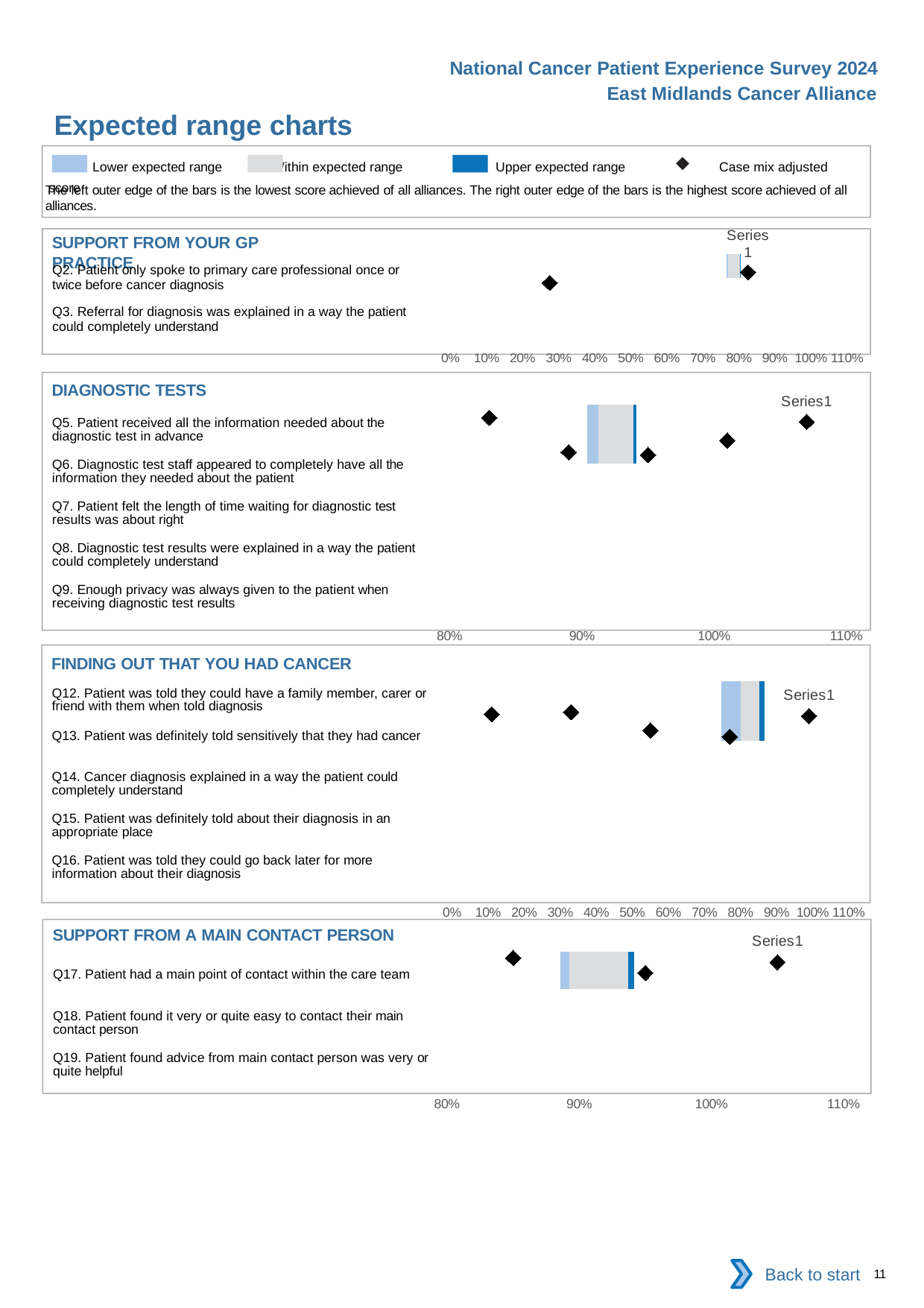
How many entries does the key at the top of the slide list? 4 How many expected range charts are shown on the slide? 4 What kind of chart is used in the DIAGNOSTIC TESTS section? bar chart In the SUPPORT FROM A MAIN CONTACT PERSON chart, is the leftmost diamond marker greater or less than 90%? less How many questions are listed in the SUPPORT FROM YOUR GP PRACTICE chart? 2 How many questions are listed in the FINDING OUT THAT YOU HAD CANCER chart? 5 What is the lowest value shown on the x axis of the DIAGNOSTIC TESTS chart? 80% According to the key, what does the diamond marker represent? Case mix adjusted score